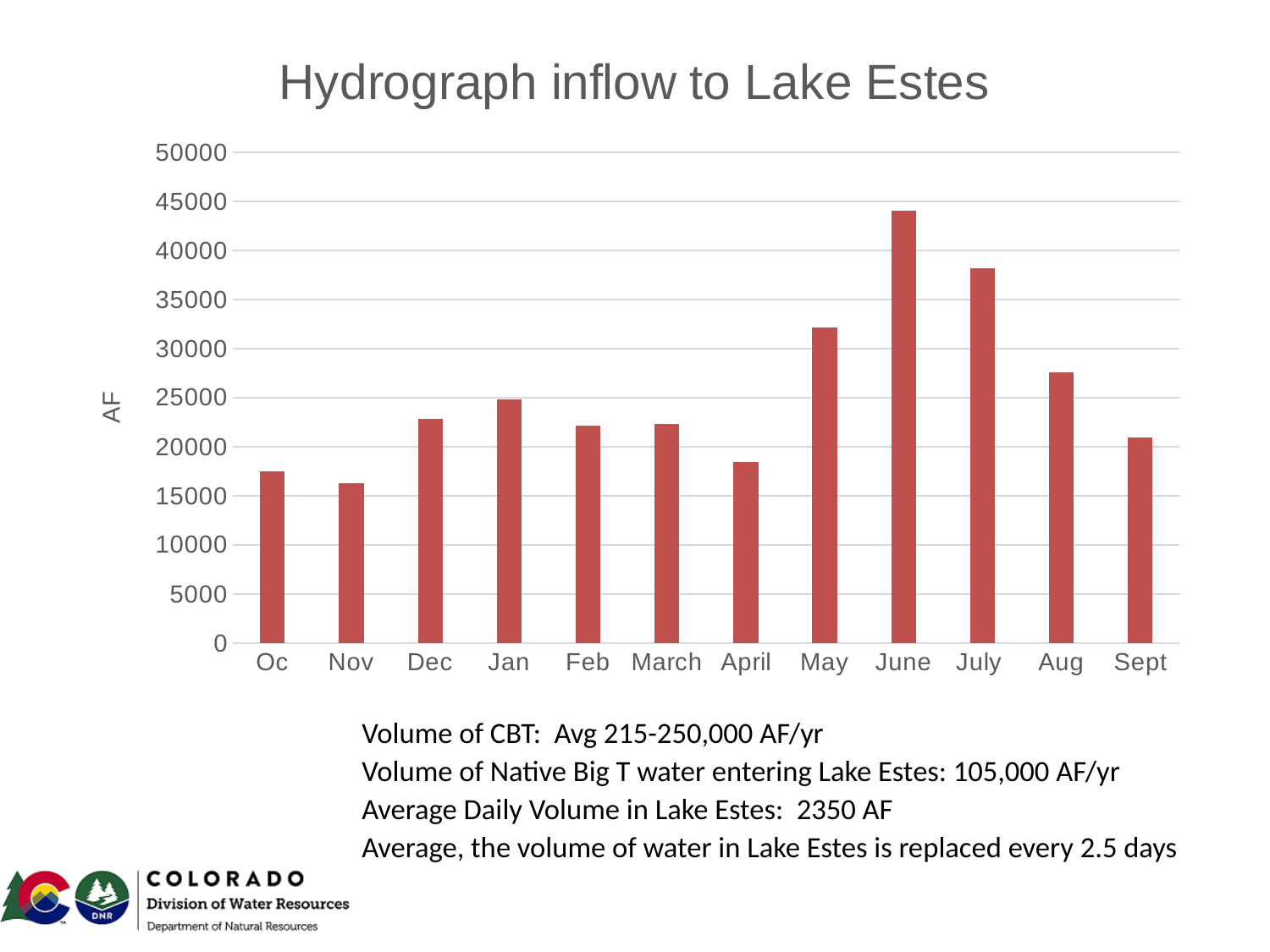
Which month has a larger inflow, July or Aug? July What is the title of the chart? Hydrograph inflow to Lake Estes Which month has the lowest inflow to Lake Estes? Nov Do the inflow values rise or fall from June to Sept? fall Is the inflow for April greater or less than 20000? less How many months are shown on the x axis of the chart? 12 What kind of chart is shown on the slide? bar chart Is the inflow for May greater or less than 30000? greater Which month has the highest inflow to Lake Estes? June What is the label on the vertical axis of the chart? AF Is the inflow for June greater or less than 40000? greater